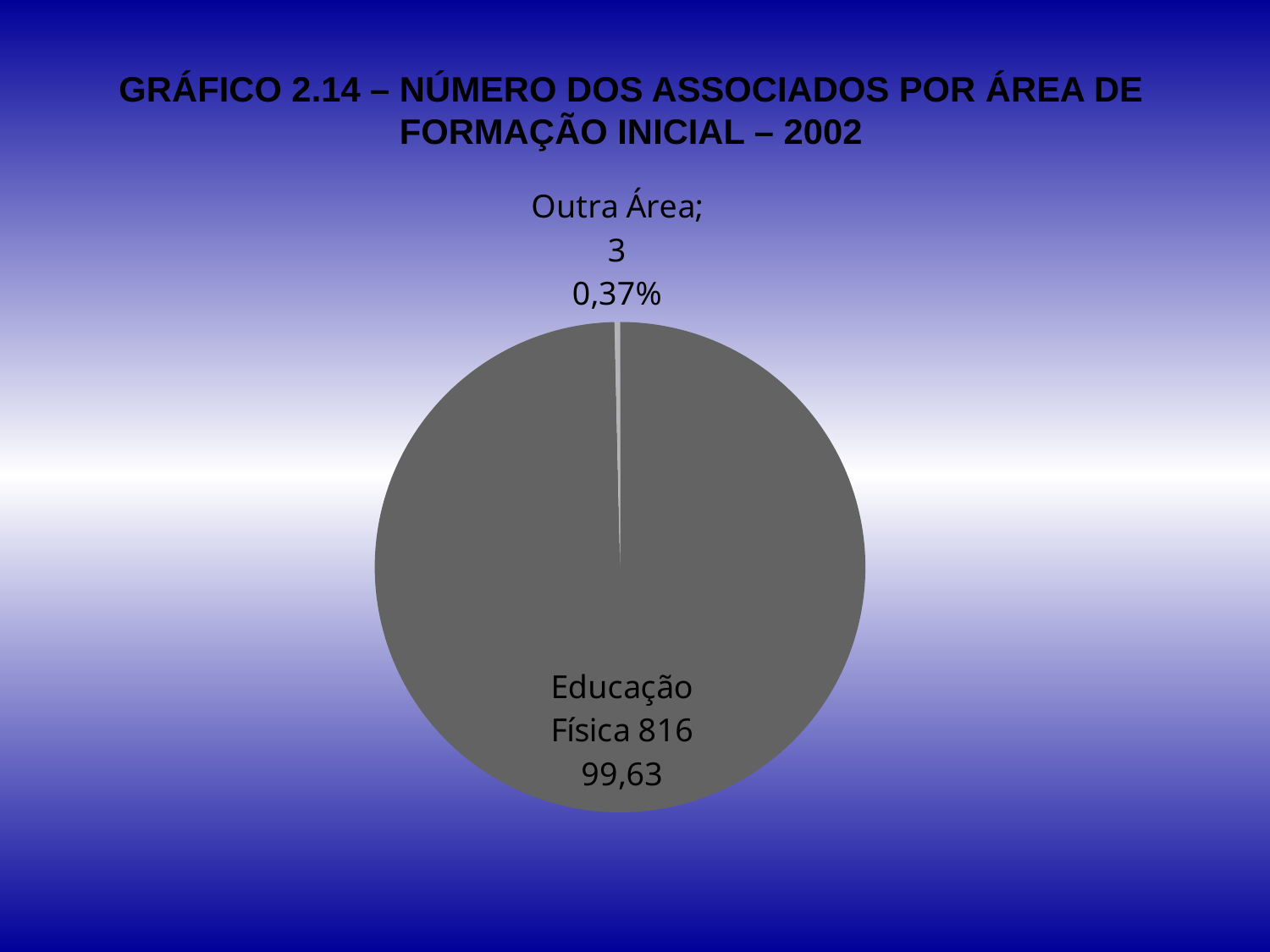
What percentage share does Outra Área have? 0,37% How many slices does the pie chart have? 2 Which category has the smallest slice? Outra Área What is the number of associates for Educação Física? 816 What is the difference between the number of associates in Educação Física and Outra Área? 813 What is the number of associates for Outra Área? 3 Which category has the largest slice? Educação Física What kind of chart is shown on the slide? pie chart What is the total number of associates across both categories? 819 What percentage share does Educação Física have? 99,63 What year does the chart title refer to? 2002 Which is larger, the value for Educação Física or the value for Outra Área? Educação Física